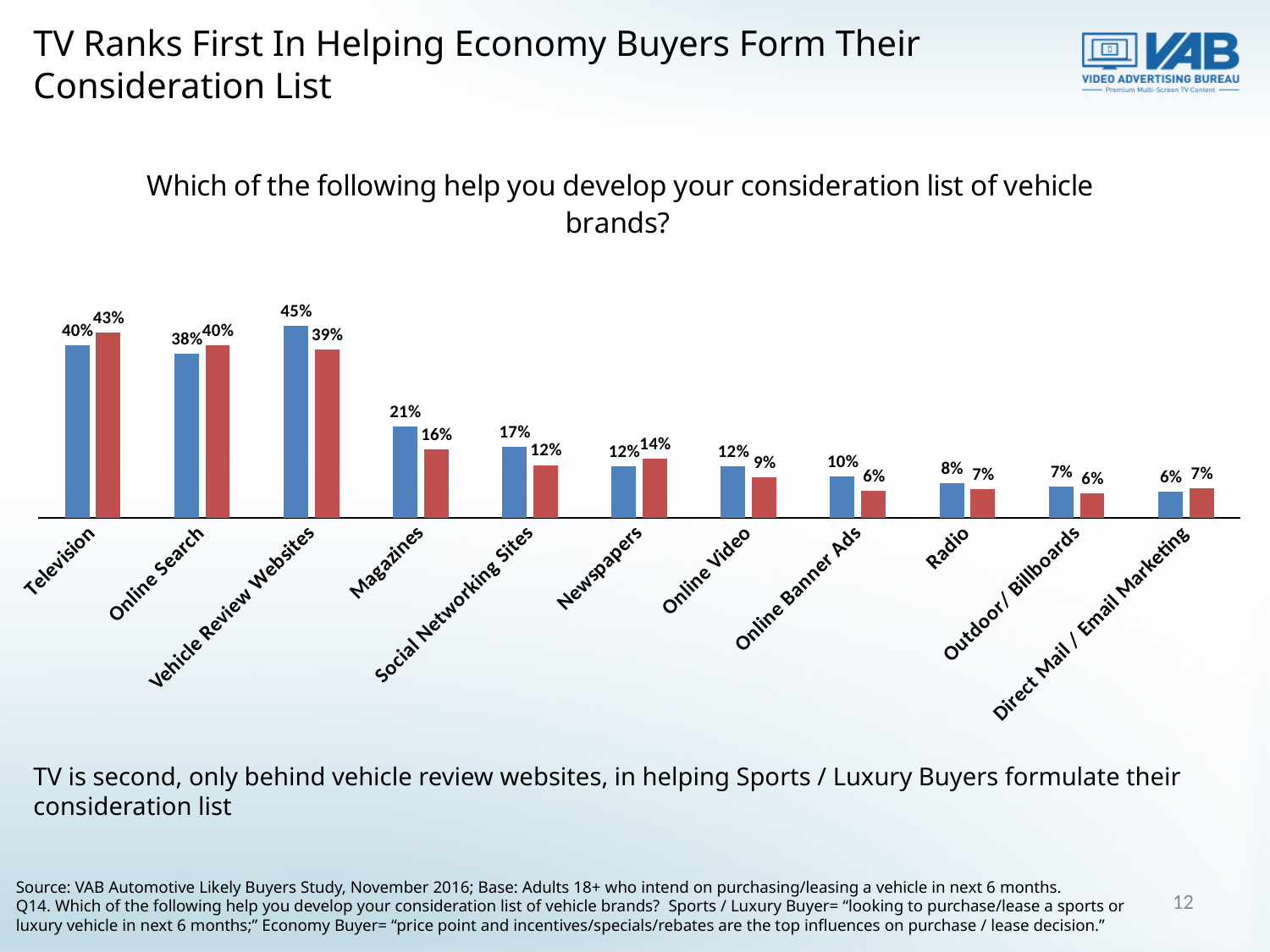
Which category has the highest value among the red bars? Television What type of chart is shown on the slide? Bar chart What is the difference between the blue and red bars for Vehicle Review Websites? 6% What is the value of the red bar for Television? 43% How many categories are shown on the x axis? 11 What is the value of the blue bar for Television? 40% Which category has the highest value among the blue bars? Vehicle Review Websites Which category has the lowest value among the blue bars? Direct Mail / Email Marketing What is the value of the blue bar for Vehicle Review Websites? 45% Which is larger for Newspapers, the blue bar or the red bar? The red bar What is the value of the red bar for Magazines? 16% What is the value of the blue bar for Online Banner Ads? 10%